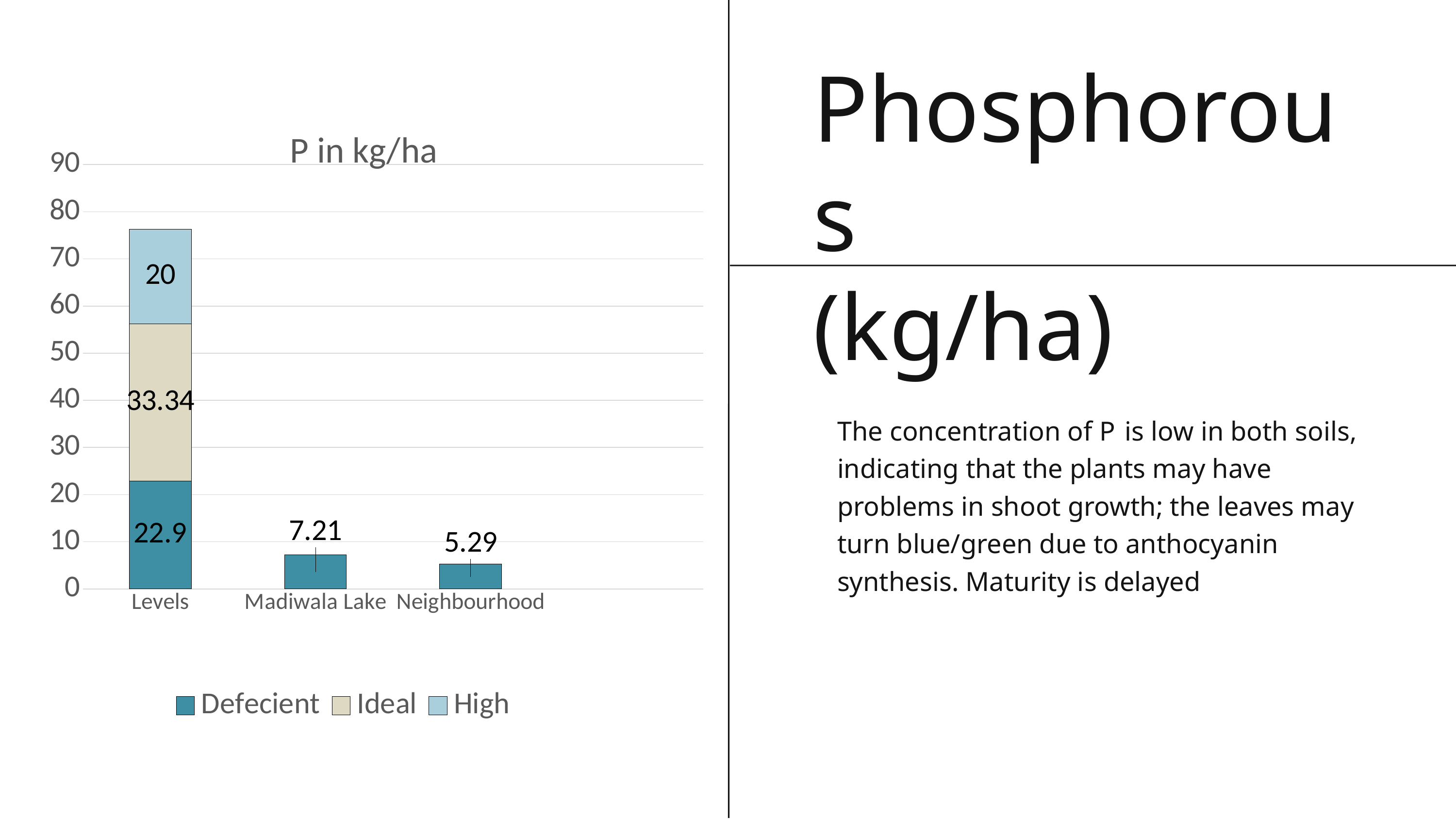
What is the High value for the Levels bar? 20 Which is larger, the value for Madiwala Lake or the value for Neighbourhood? Madiwala Lake What is the title of the chart? P in kg/ha What is the value for Neighbourhood? 5.29 What kind of chart is shown on the slide? bar chart What is the value for Madiwala Lake? 7.21 What is the total of the stacked Levels bar? 76.24 What is the Defecient value for the Levels bar? 22.9 How many categories are shown on the x axis of the chart? 3 What is the difference between the Madiwala Lake value and the Neighbourhood value? 1.92 What is the Ideal value for the Levels bar? 33.34 How many series does the chart legend list? 3